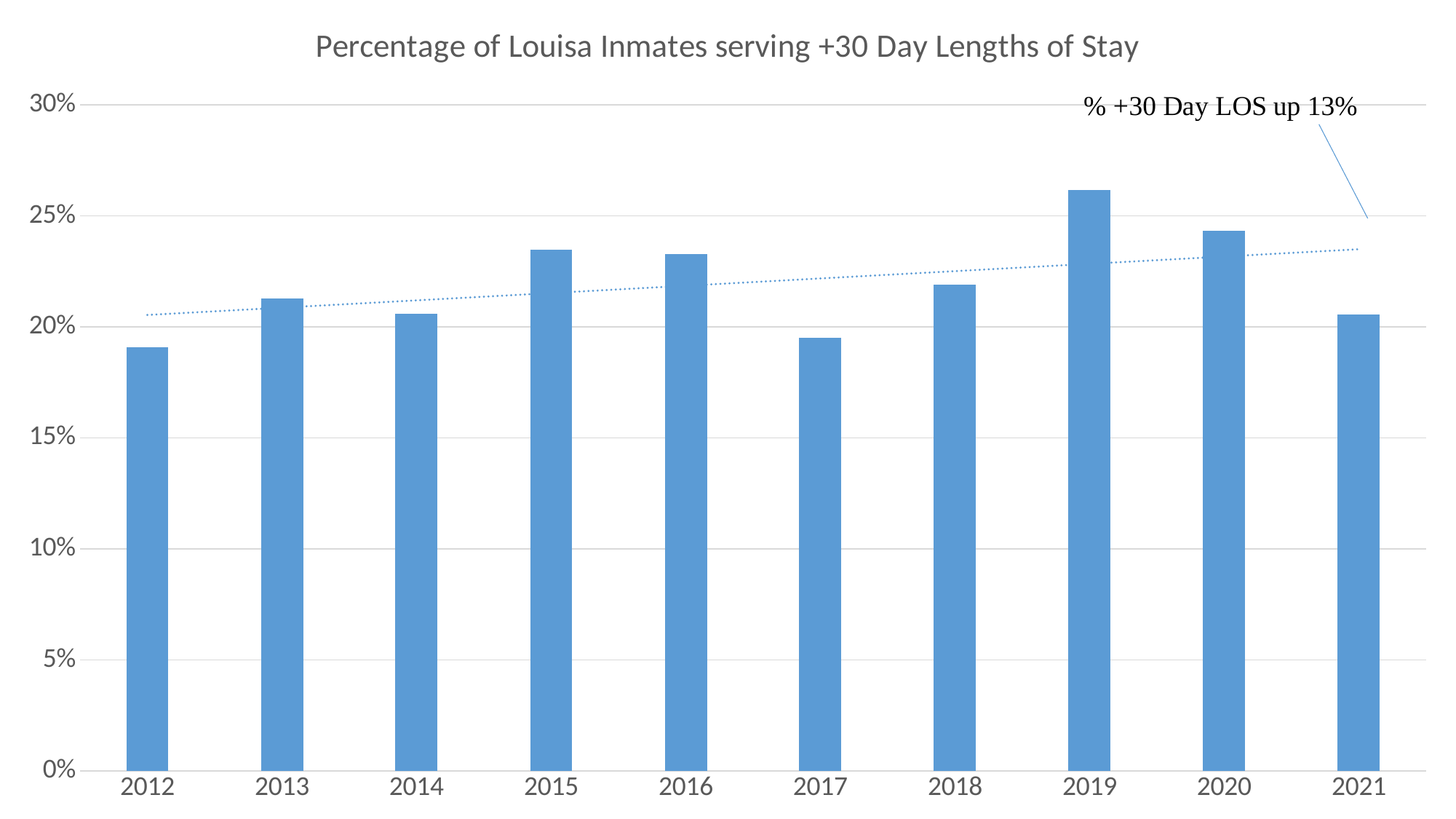
How many years are shown on the x axis of the chart? 10 Is the value for 2015 greater or less than 20%? greater Which is larger, the value for 2019 or the value for 2021? 2019 Which year has the highest percentage of inmates serving +30 day lengths of stay? 2019 Which is larger, the value for 2015 or the value for 2014? 2015 What is the title of the chart? Percentage of Louisa Inmates serving +30 Day Lengths of Stay Is the value for 2012 greater or less than 20%? less Does the dotted trendline on the chart rise or fall from 2012 to 2021? rise What kind of chart is shown on the slide? bar chart Is the value for 2017 greater or less than 20%? less